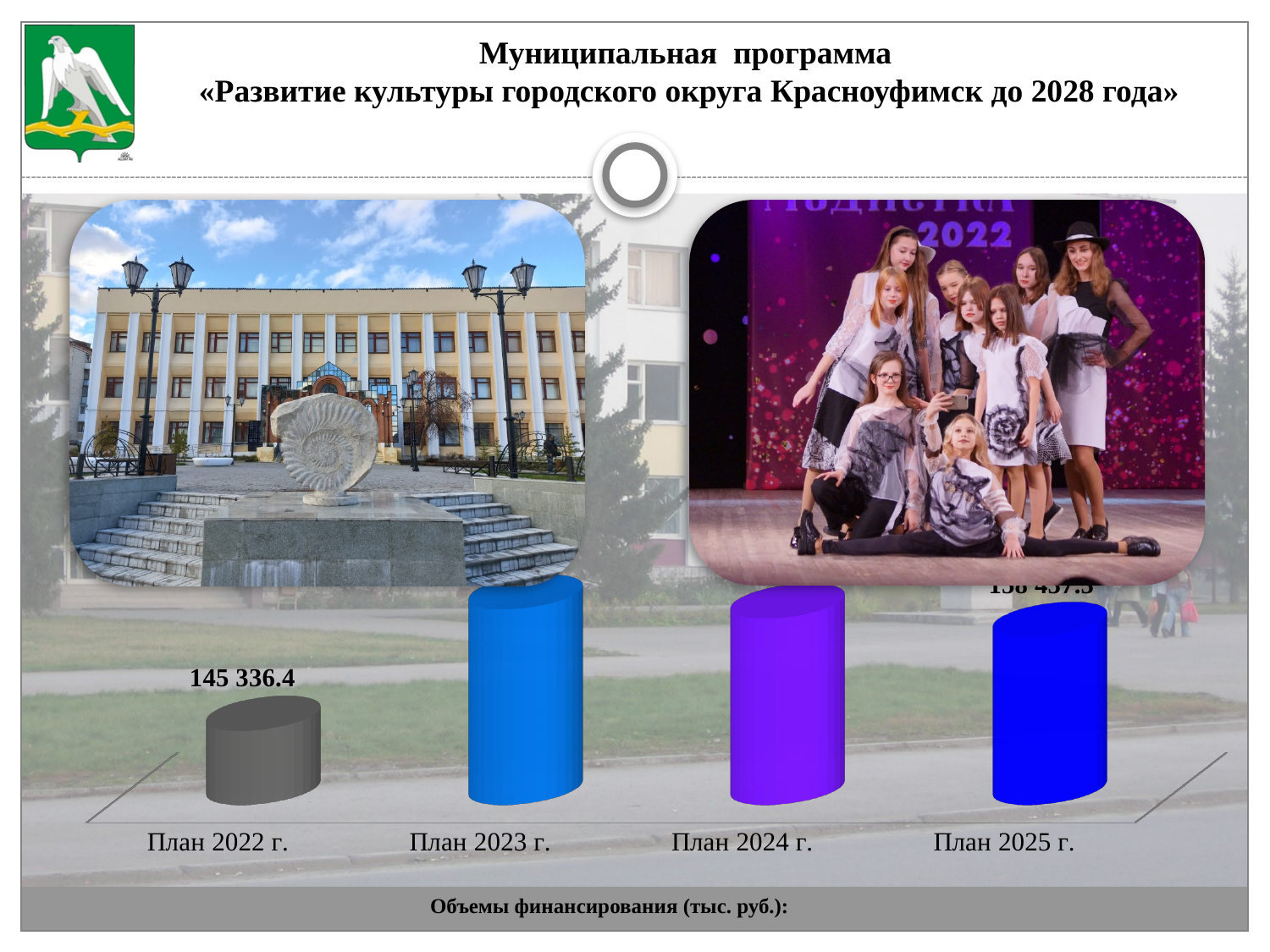
How many categories are shown on the chart? 4 What is the label of the first category on the x axis? План 2022 г. What is the value shown for План 2022 г.? 145 336.4 What kind of chart is shown on the slide? Bar chart What unit is stated in the chart caption at the bottom of the slide? тыс. руб. Which is larger, the value for План 2022 г. or the value for План 2024 г.? План 2024 г. Which category has the lowest value? План 2022 г. Which is larger, the value for План 2022 г. or the value for План 2023 г.? План 2023 г. Which is larger, the value for План 2022 г. or the value for План 2025 г.? План 2025 г. Does the value rise or fall from План 2022 г. to План 2023 г.? Rise